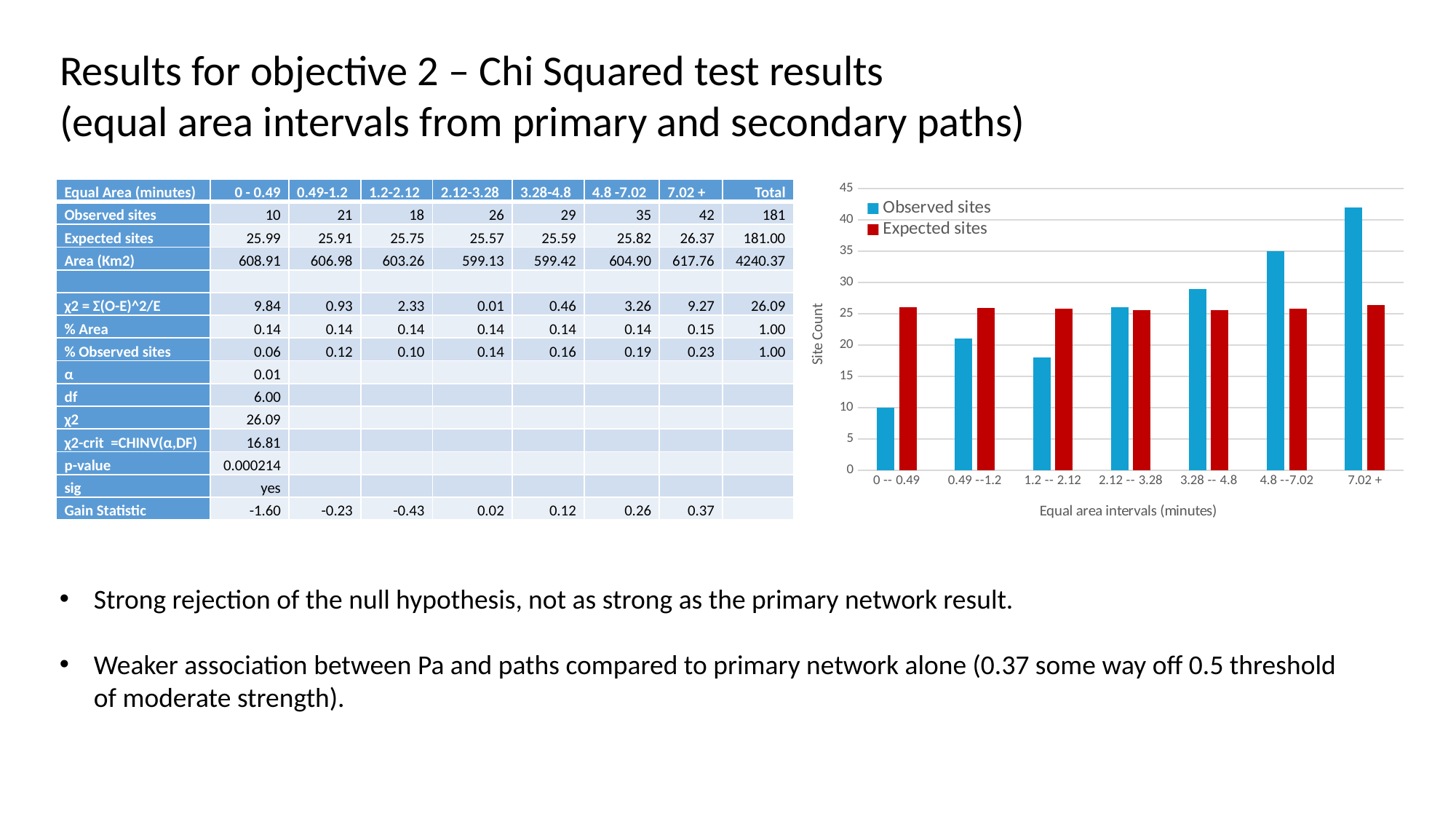
How many series does the chart's legend list? 2 For the 0 -- 0.49 interval, which is larger: Observed sites or Expected sites? Expected sites What is the title of the chart's y axis? Site Count What is the Observed sites value for the 0 -- 0.49 interval? 10 How many equal area interval categories are plotted on the x axis of the chart? 7 What kind of chart is shown on the slide? bar chart Which equal area interval has the lowest Observed sites value in the chart? 0 -- 0.49 Is the Observed sites value for the 1.2 -- 2.12 interval greater or less than 20? less Do the Observed sites values generally rise or fall moving from left to right along the x axis? rise Which equal area interval has the highest Observed sites value in the chart? 7.02 + For the 7.02 + interval, which is larger: Observed sites or Expected sites? Observed sites What is the Observed sites value for the 4.8 --7.02 interval? 35